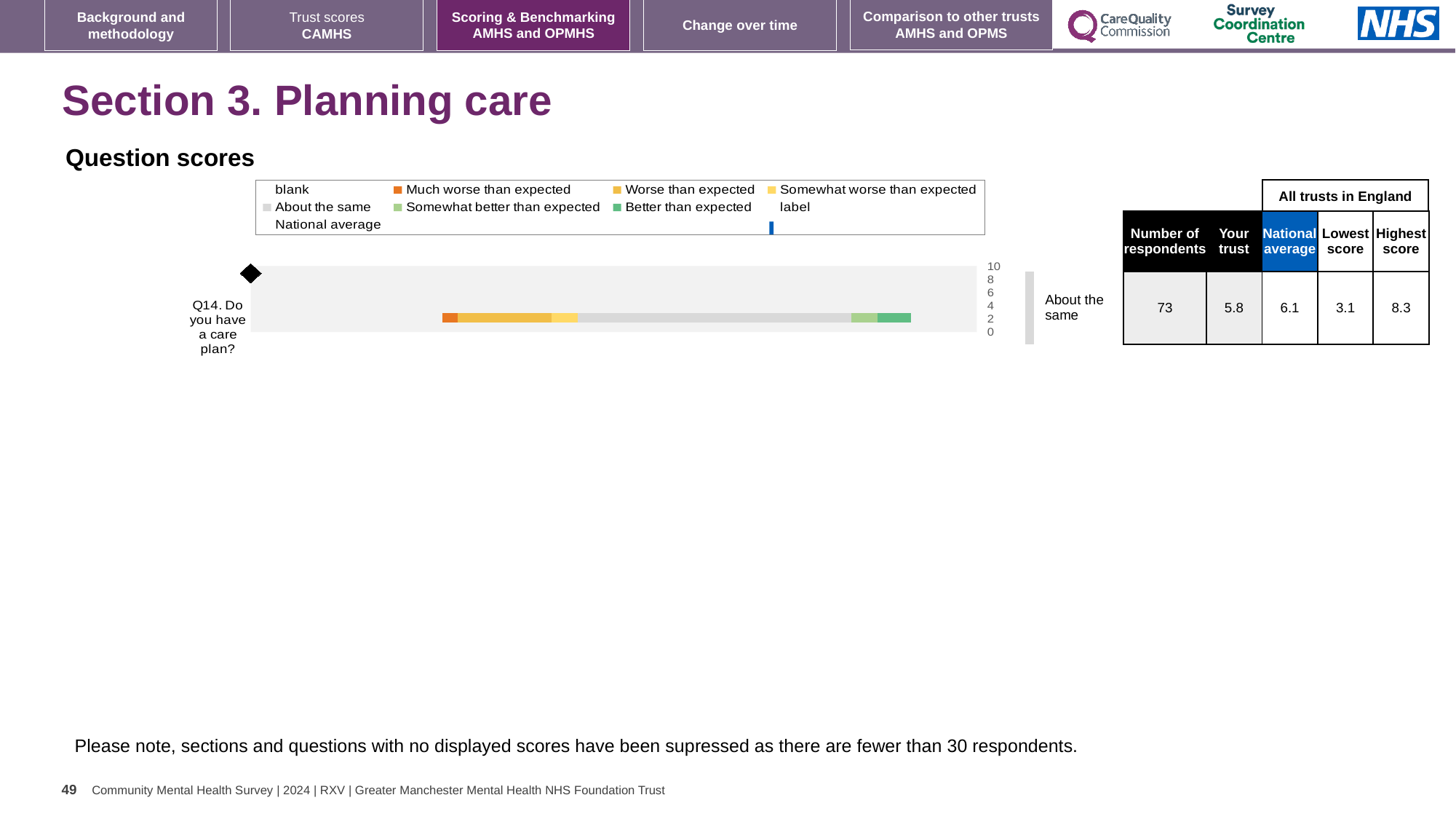
What is the difference between the highest and lowest scores for Q14? 5.2 What is the 'Your trust' score for Q14? 5.8 What is the highest score among all trusts in England for Q14? 8.3 For Q14, which is larger: the 'Your trust' score or the national average? National average How many questions are plotted in the Question scores chart? 1 By how much does the national average exceed the 'Your trust' score for Q14? 0.3 What benchmark category is shown next to the bar for Q14? About the same What is the lowest score among all trusts in England for Q14? 3.1 What is the number of respondents for Q14? 73 What kind of chart is used to show the Q14 question score? bar chart Which question is plotted in the Question scores chart? Q14. Do you have a care plan? What is the national average score for Q14? 6.1